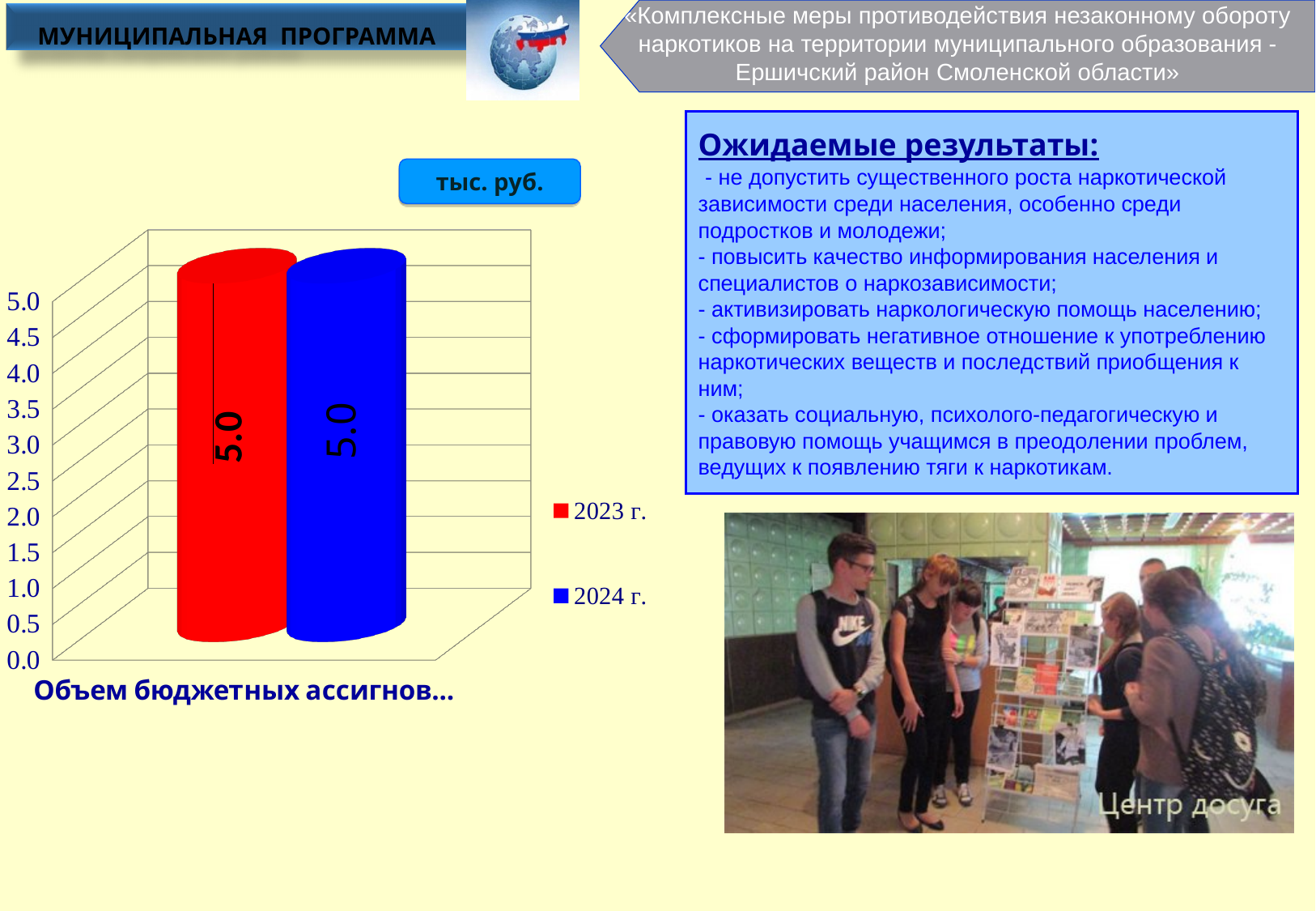
What kind of chart is shown on the slide? bar chart What is the value of the red bar for 2023 г. in the chart? 5.0 How many categories are shown on the x axis of the chart? 1 Is the value for 2023 г. larger than, smaller than, or equal to the value for 2024 г.? equal What is the difference between the 2023 г. value and the 2024 г. value in the chart? 0.0 What unit is shown in the label above the chart? тыс. руб. Is the value for 2024 г. greater or less than 2.0? greater How many series does the chart legend list? 2 What is the highest tick value shown on the vertical axis of the chart? 5.0 What colour is the bar for 2023 г. in the chart? red What is the value of the blue bar for 2024 г. in the chart? 5.0